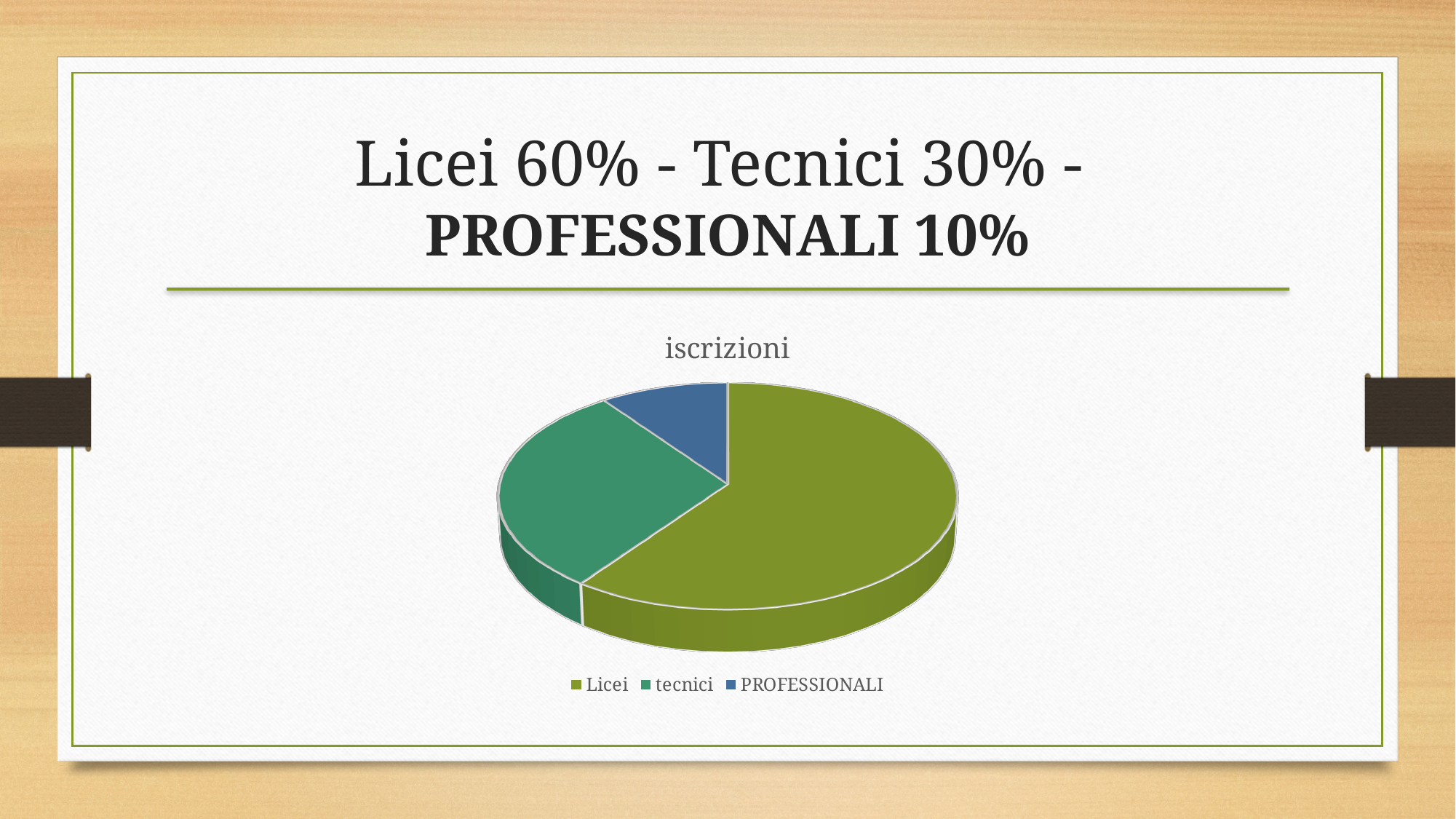
How many slices does the pie chart have? 3 What kind of chart is shown on the slide? pie chart Which is larger, the slice for tecnici or the slice for PROFESSIONALI? tecnici Which category has the smallest slice of the pie? PROFESSIONALI What share of the pie does tecnici represent? 30% How many entries does the chart legend list? 3 Which colour is used for the PROFESSIONALI slice? blue What is the title of the chart? iscrizioni What share of the pie does PROFESSIONALI represent? 10% What is the difference in percentage points between the Licei share and the tecnici share? 30% What share of the pie does Licei represent? 60% Which category has the largest slice of the pie? Licei